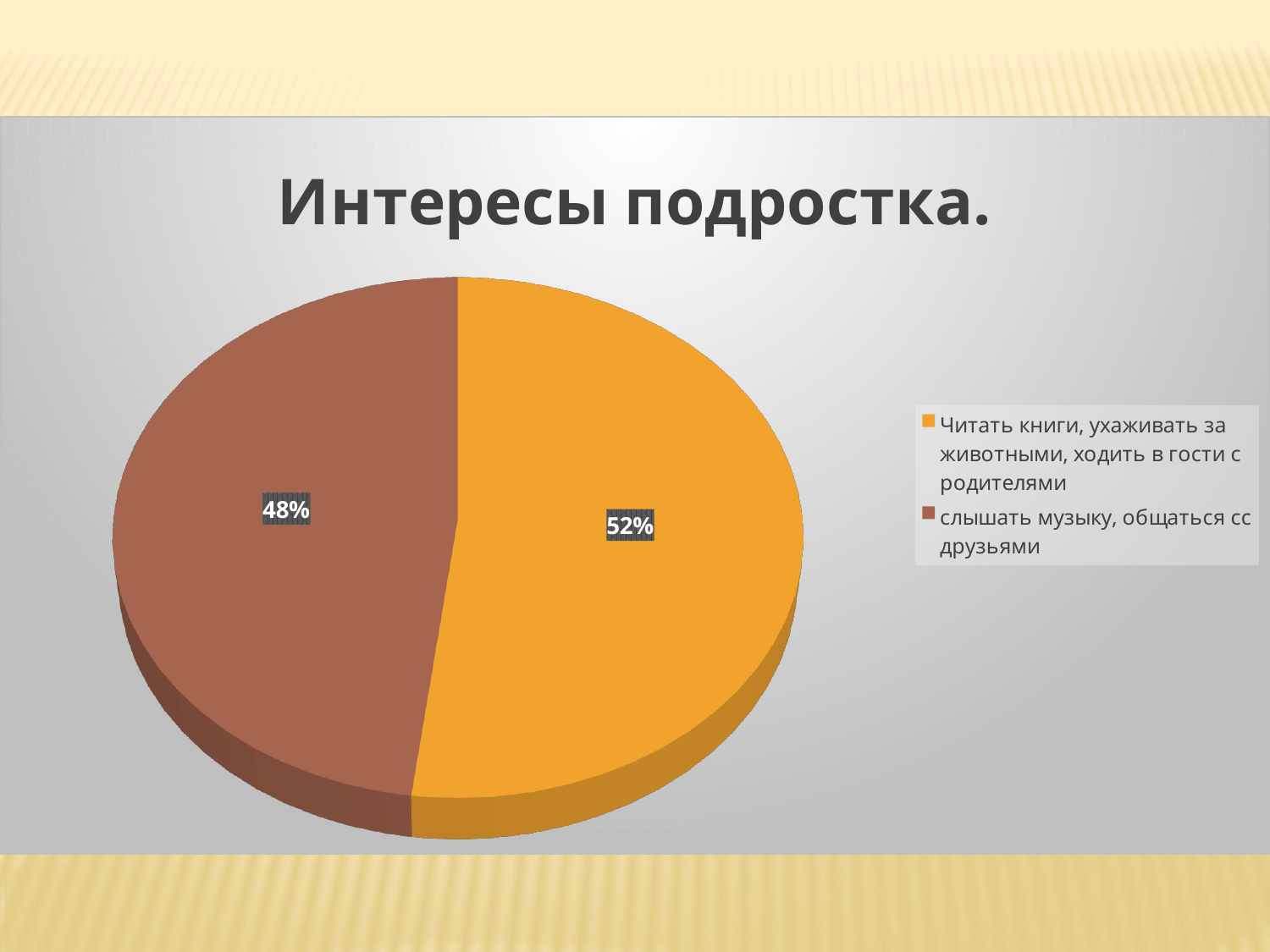
Which category has the largest slice of the pie? Читать книги, ухаживать за животными, ходить в гости с родителями What share of the pie is labelled for "Читать книги, ухаживать за животными, ходить в гости с родителями"? 52% What kind of chart is shown on the slide? Pie chart What is the title of the chart? Интересы подростка. What is the share of the orange slice in the pie? 52% Which category has the smallest slice of the pie? слышать музыку, общаться с друзьями Which is larger: the slice for "Читать книги, ухаживать за животными, ходить в гости с родителями" or the slice for "слышать музыку, общаться с друзьями"? Читать книги, ухаживать за животными, ходить в гости с родителями What share of the pie is labelled for "слышать музыку, общаться с друзьями"? 48% How many slices does the pie chart have? 2 What colour is the slice labelled 48%? Brown By how many percentage points does the "Читать книги..." slice exceed the "слышать музыку..." slice? 4 percentage points How many entries does the legend list? 2